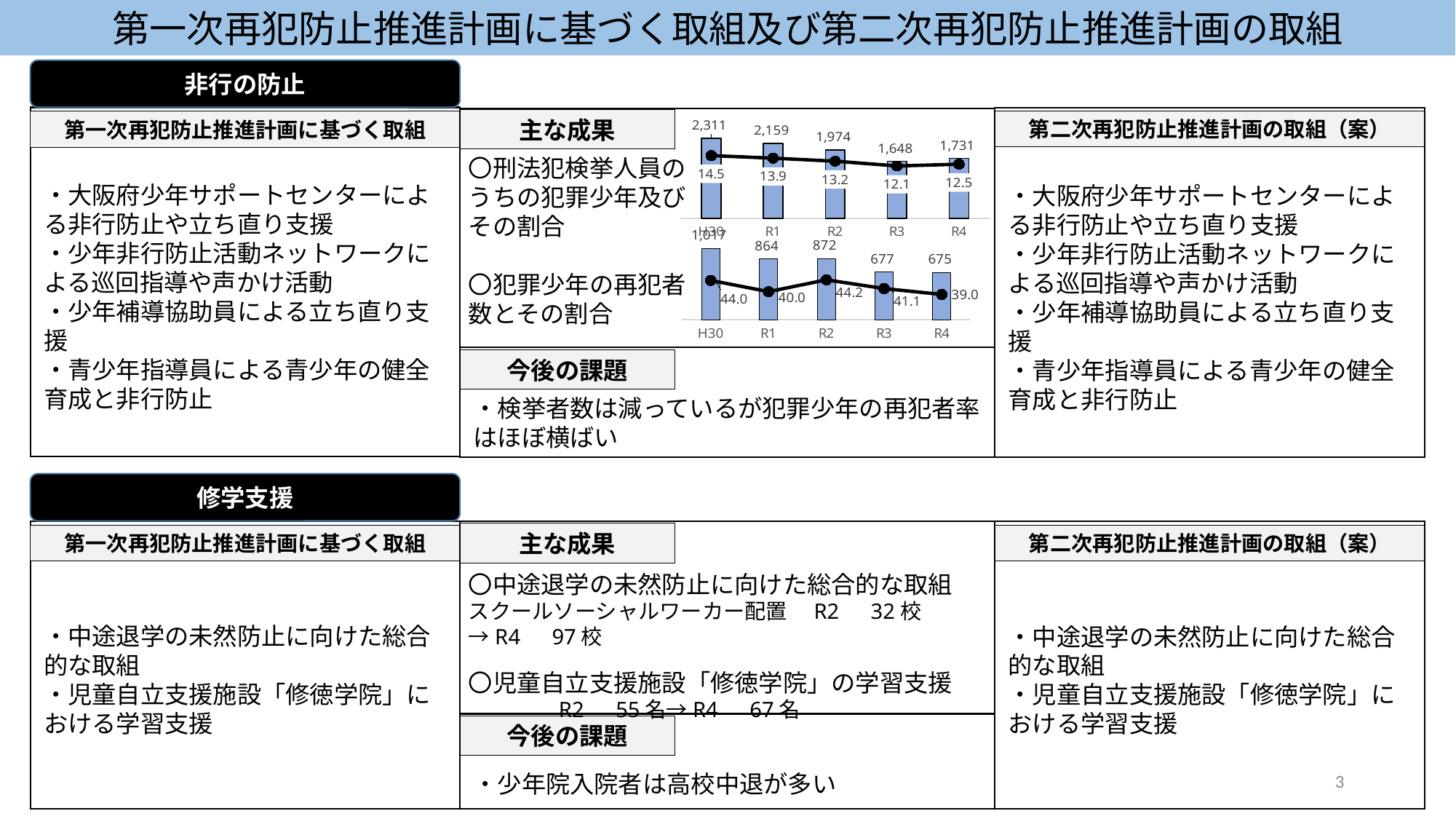
In the lower chart, which bar is larger, R2 or R3? R2 In the lower chart, what is the line value (割合) for R4? 39.0 How many years are shown on the x axis of the upper chart? 5 In the upper chart, what is the line value (割合) for R3? 12.1 In the upper chart, which year has the highest bar value? H30 In the lower chart, which year has the highest line value? R2 In the upper chart, which year has the lowest bar value? R3 In the upper chart, what is the difference between the bar values for H30 and R4? 580 In the upper chart (刑法犯検挙人員のうちの犯罪少年及びその割合), what is the bar value for H30? 2,311 What kind of chart is the lower chart? Combined bar and line chart In the lower chart (犯罪少年の再犯者数とその割合), what is the bar value for R1? 864 In the upper chart, does the line value fall or rise from H30 to R3? fall